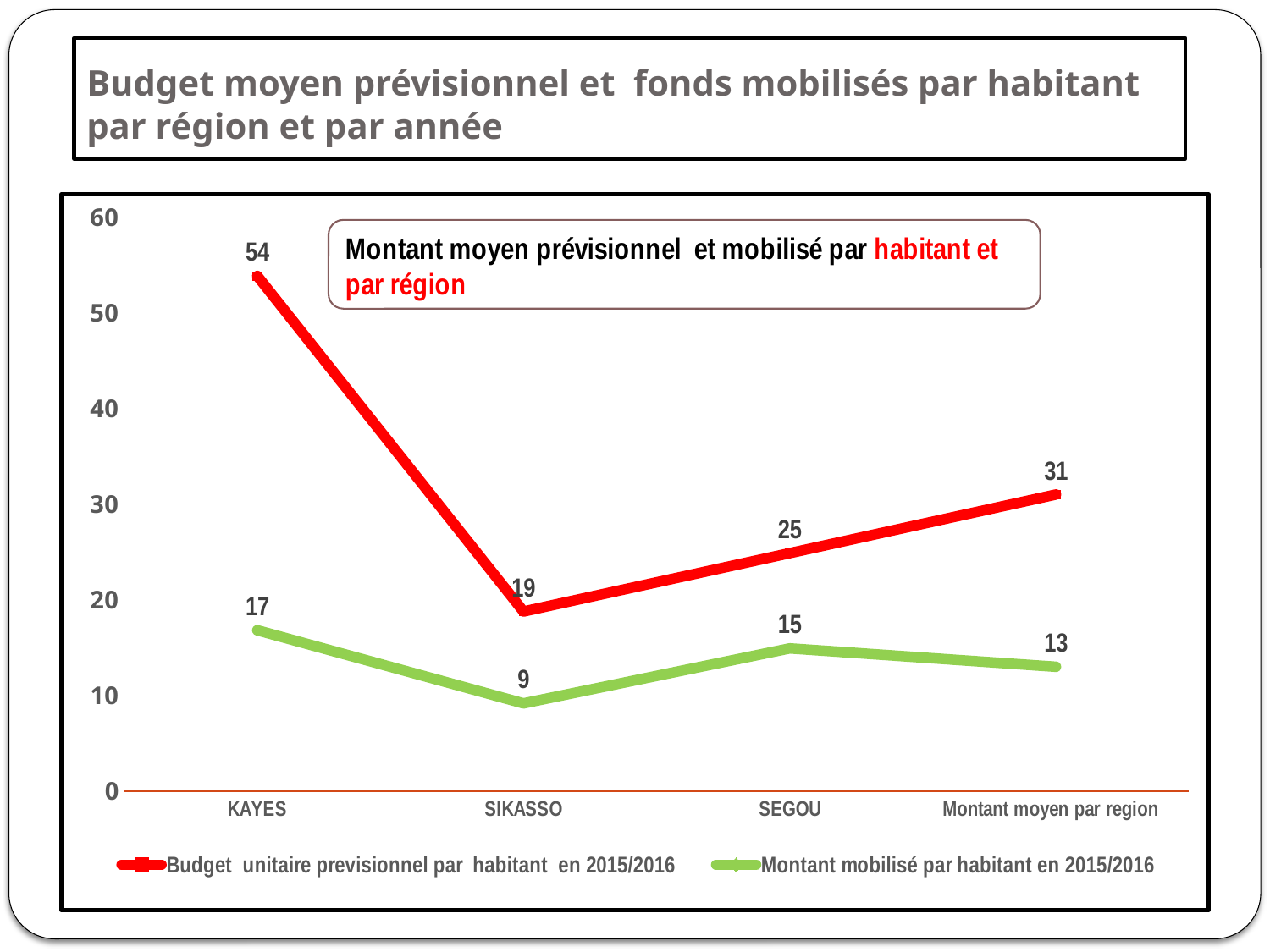
What is the value of 'Budget unitaire previsionnel par habitant en 2015/2016' for KAYES? 54 Is the 'Budget unitaire previsionnel par habitant' value for SIKASSO greater or less than 20? less Which is larger: the 'Montant mobilisé par habitant' value for KAYES or for SEGOU? KAYES Which category has the lowest value for 'Montant mobilisé par habitant en 2015/2016'? SIKASSO What is the difference between the 'Budget unitaire previsionnel' and 'Montant mobilisé' values for SEGOU? 10 Which category has the highest value for 'Budget unitaire previsionnel par habitant en 2015/2016'? KAYES What kind of chart is shown on the slide? line chart What is the value of 'Budget unitaire previsionnel par habitant en 2015/2016' for 'Montant moyen par region'? 31 What colour is the line for 'Montant mobilisé par habitant en 2015/2016'? green How many categories are shown on the x axis? 4 What is the value of 'Montant mobilisé par habitant en 2015/2016' for SIKASSO? 9 How many series does the legend list? 2